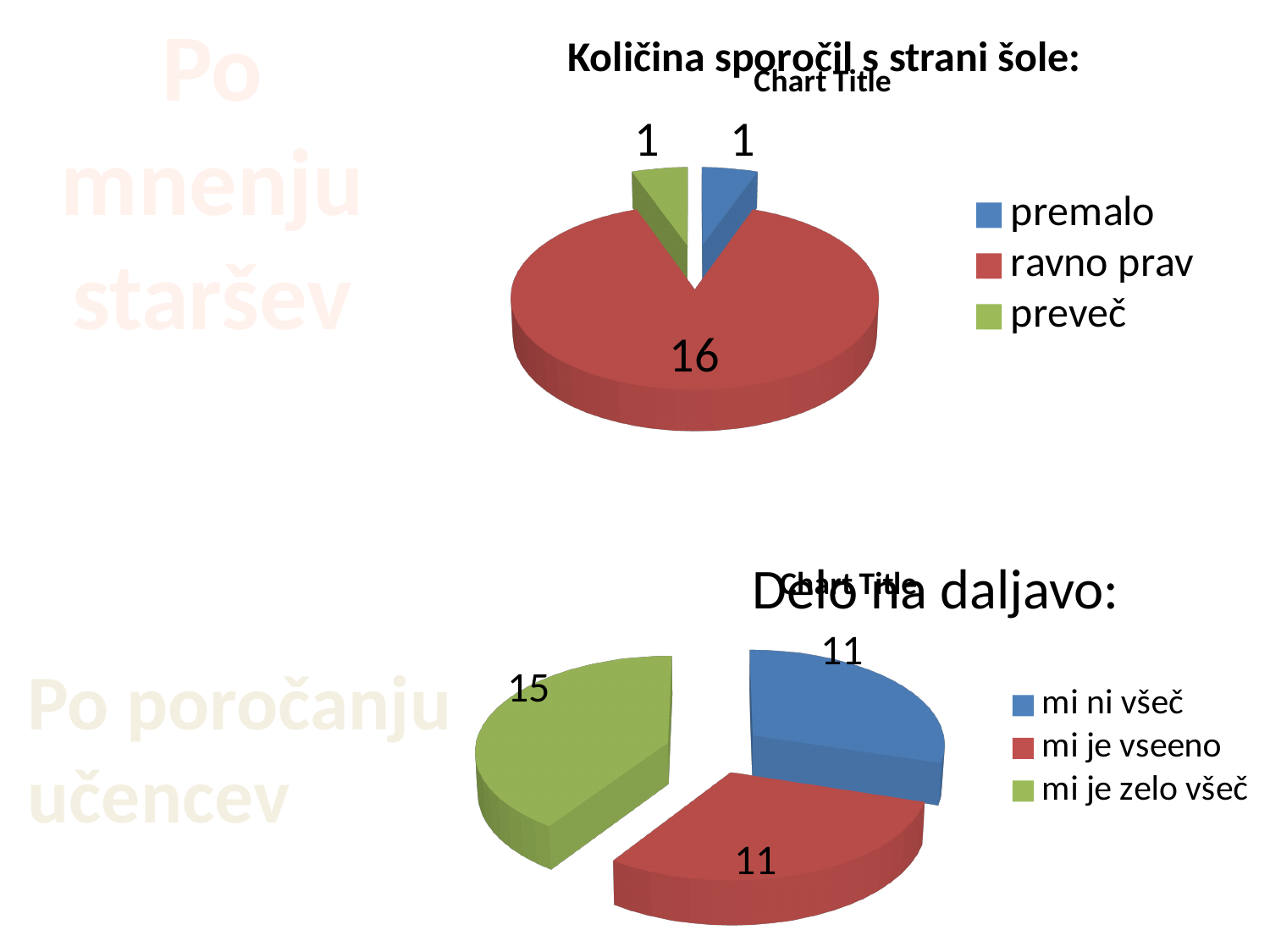
In the top chart (Količina sporočil s strani šole), which category has the largest slice? ravno prav In the bottom chart (Delo na daljavo), what is the value for "mi ni všeč"? 11 In the top chart (Količina sporočil s strani šole), what is the value for "ravno prav"? 16 In the bottom chart (Delo na daljavo), which category has the largest slice? mi je zelo všeč In the bottom chart (Delo na daljavo), what is the value for "mi je zelo všeč"? 15 In the bottom chart (Delo na daljavo), how many slices does the pie have? 3 In the bottom chart (Delo na daljavo), what colour is the slice for "mi je vseeno"? red In the top chart (Količina sporočil s strani šole), what is the difference between "ravno prav" and "preveč"? 15 What kind of chart is the top chart (Količina sporočil s strani šole)? pie chart In the bottom chart (Delo na daljavo), what is the difference between "mi je zelo všeč" and "mi je vseeno"? 4 In the top chart (Količina sporočil s strani šole), what is the value for "premalo"? 1 In the top chart (Količina sporočil s strani šole), how many categories does the legend list? 3